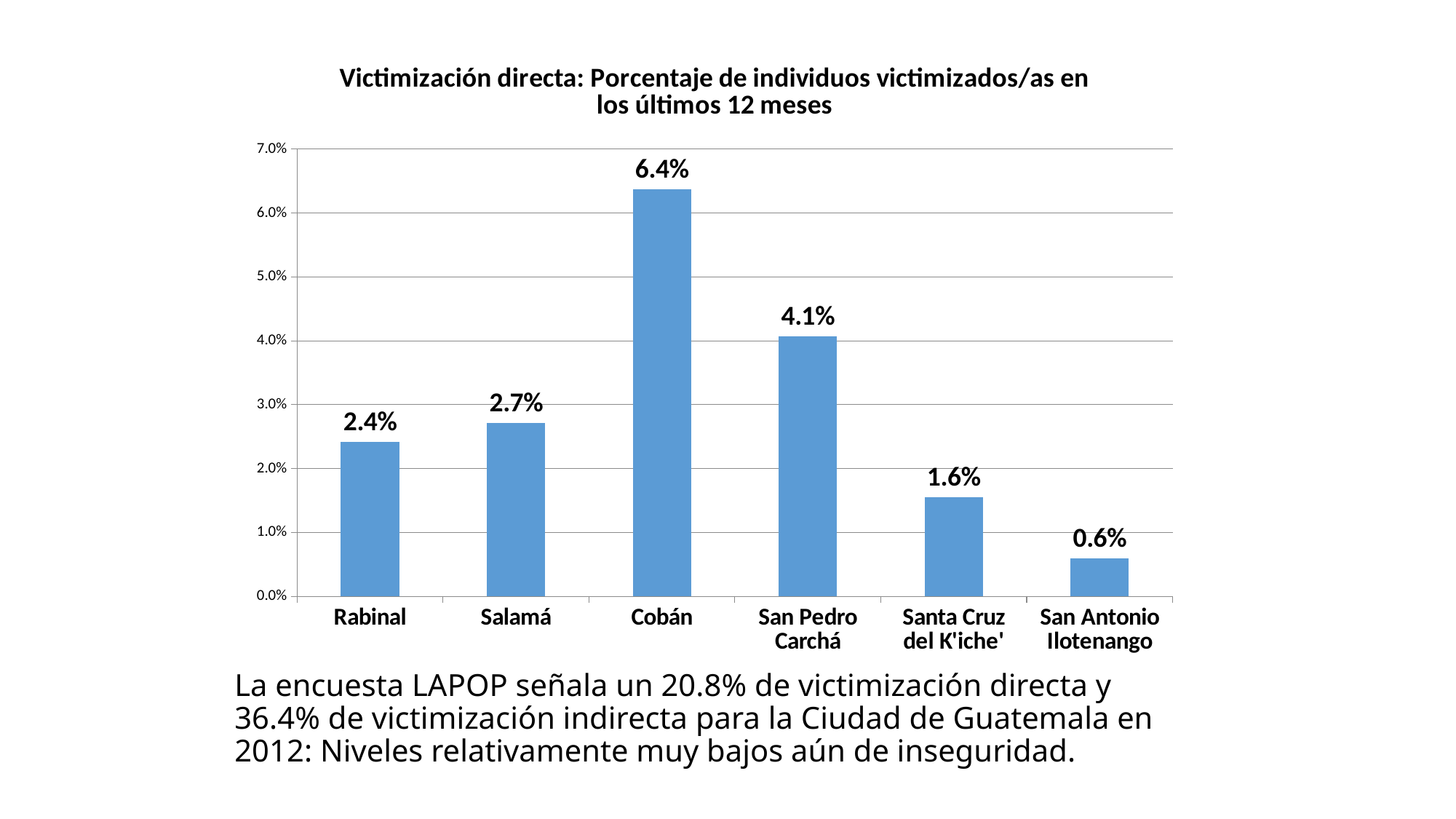
Which municipality has the lowest percentage of direct victimization? San Antonio Ilotenango What is the value for San Antonio Ilotenango? 0.6% What is the value for San Pedro Carchá? 4.1% How many municipalities are shown on the chart? 6 What is the value for Rabinal? 2.4% Is the value for Santa Cruz del K'iche' greater or less than 2.0%? less What is the title of the chart? Victimización directa: Porcentaje de individuos victimizados/as en los últimos 12 meses What is the difference between the values for Cobán and San Pedro Carchá? 2.3% Which municipality has the highest percentage of direct victimization? Cobán Which has a larger value, Salamá or Santa Cruz del K'iche'? Salamá What is the value for Cobán? 6.4% What kind of chart is shown on the slide? Bar chart